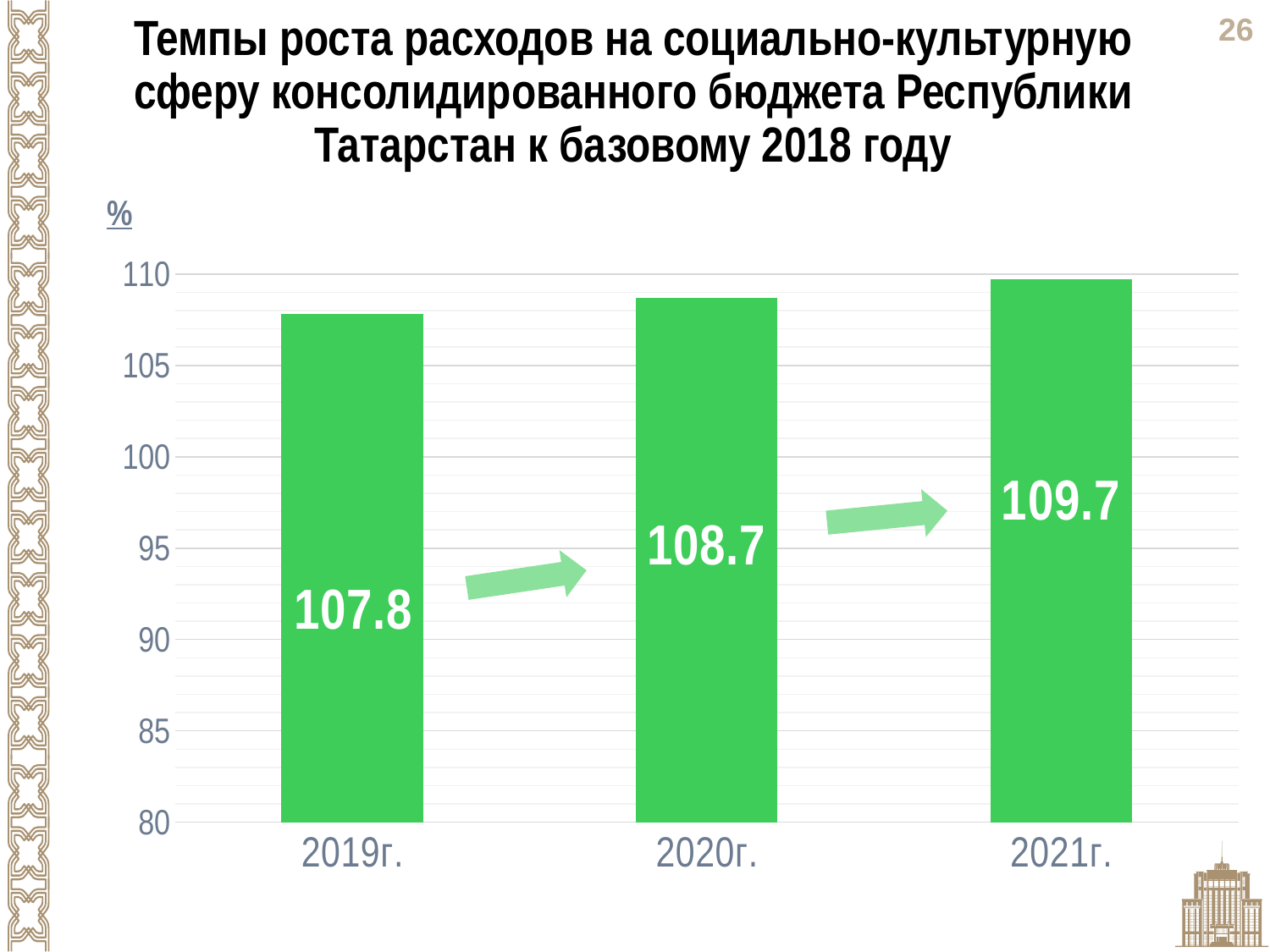
How many years are shown on the chart? 3 Which is larger, the value for 2020г. or the value for 2021г.? 2021г. What is the difference between the values for 2021г. and 2019г.? 1.9 What kind of chart is shown on the slide? bar chart Which year has the highest value? 2021г. Which year has the lowest value? 2019г. What is the value for 2020г.? 108.7 Is the value for 2019г. greater or less than 105? greater What is the value for 2019г.? 107.8 What is the value for 2021г.? 109.7 Do the values rise or fall from 2019г. to 2021г.? rise What is the difference between the values for 2020г. and 2019г.? 0.9